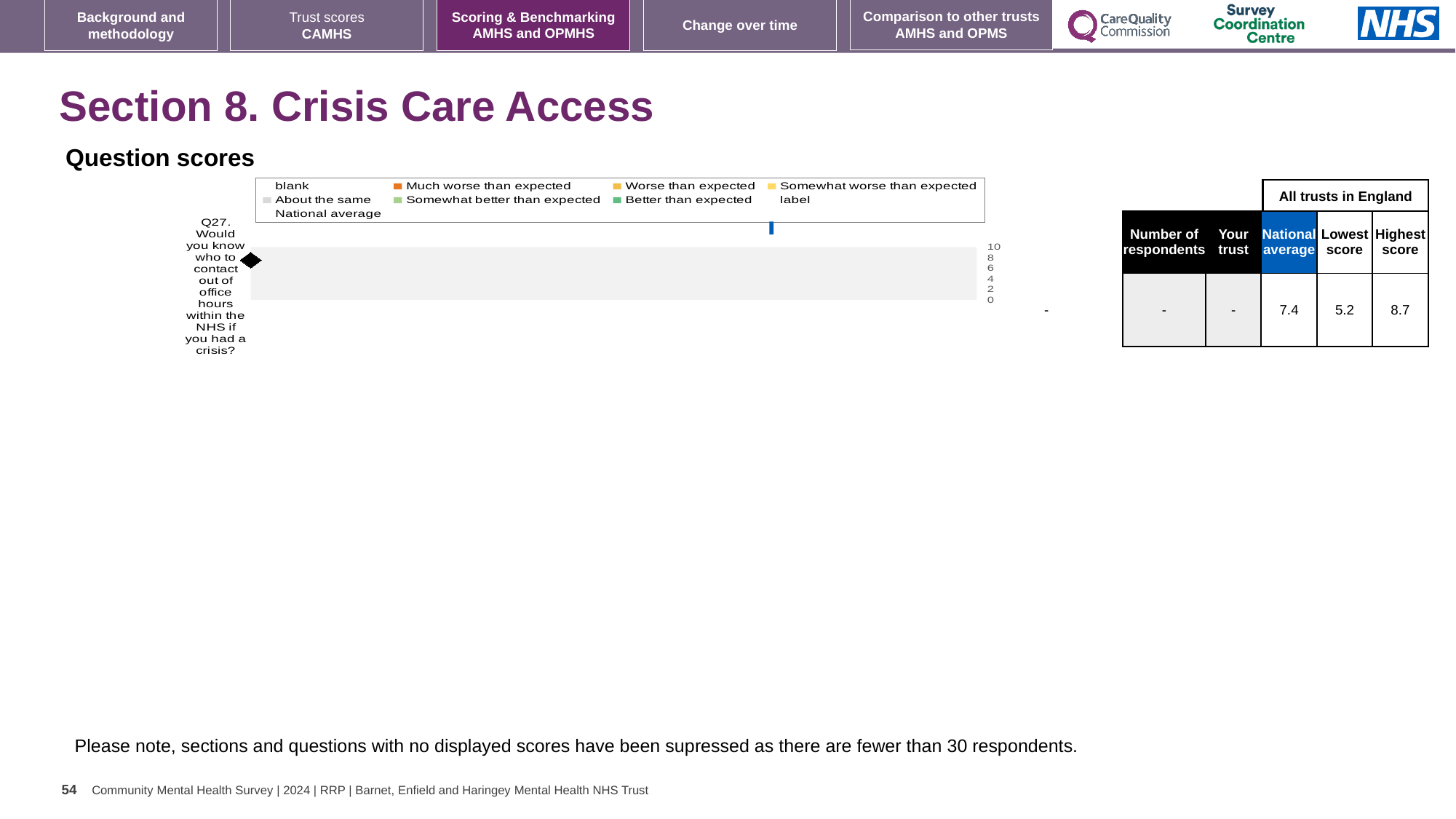
What kind of chart is shown under 'Question scores'? bar chart In the table next to the chart, what is the highest score among all trusts in England for Q27? 8.7 What is the difference between the highest score (8.7) and the lowest score (5.2) shown in the table for Q27? 3.5 In the table next to the chart, what is the national average score for Q27? 7.4 Which is larger for Q27 in the table: the national average or the lowest score? National average Which question is shown on the chart's category axis? Q27. Would you know who to contact out of office hours within the NHS if you had a crisis? How many questions (categories) are plotted on the chart? 1 In the table next to the chart, what is the lowest score among all trusts in England for Q27? 5.2 Is the national average score for Q27 greater or less than 6? greater What is the highest value shown on the chart's value axis? 10